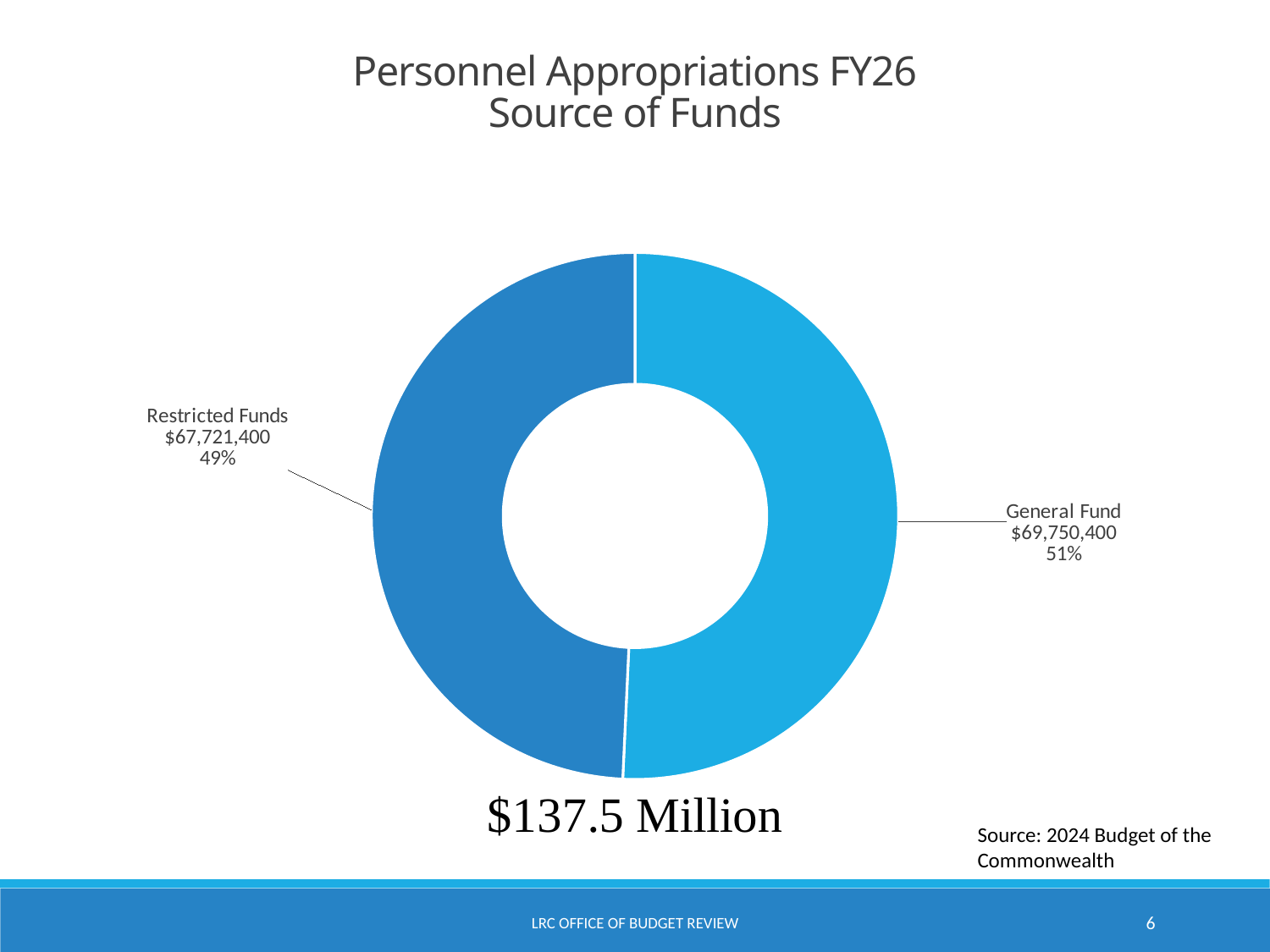
Is the General Fund value larger or smaller than the Restricted Funds value? larger What percentage share of the chart is Restricted Funds? 49% What kind of chart is shown on the slide? Doughnut (pie) chart What is the title of the chart? Personnel Appropriations FY26 Source of Funds What percentage share of the chart is the General Fund? 51% Which source of funds has the larger value? General Fund What is the difference in dollars between the General Fund and Restricted Funds? $2,029,000 What total amount is printed below the chart? $137.5 Million What is the dollar value of the Restricted Funds slice? $67,721,400 What is the dollar value of the General Fund slice? $69,750,400 Which source of funds has the smaller value? Restricted Funds How many slices does the chart have? 2